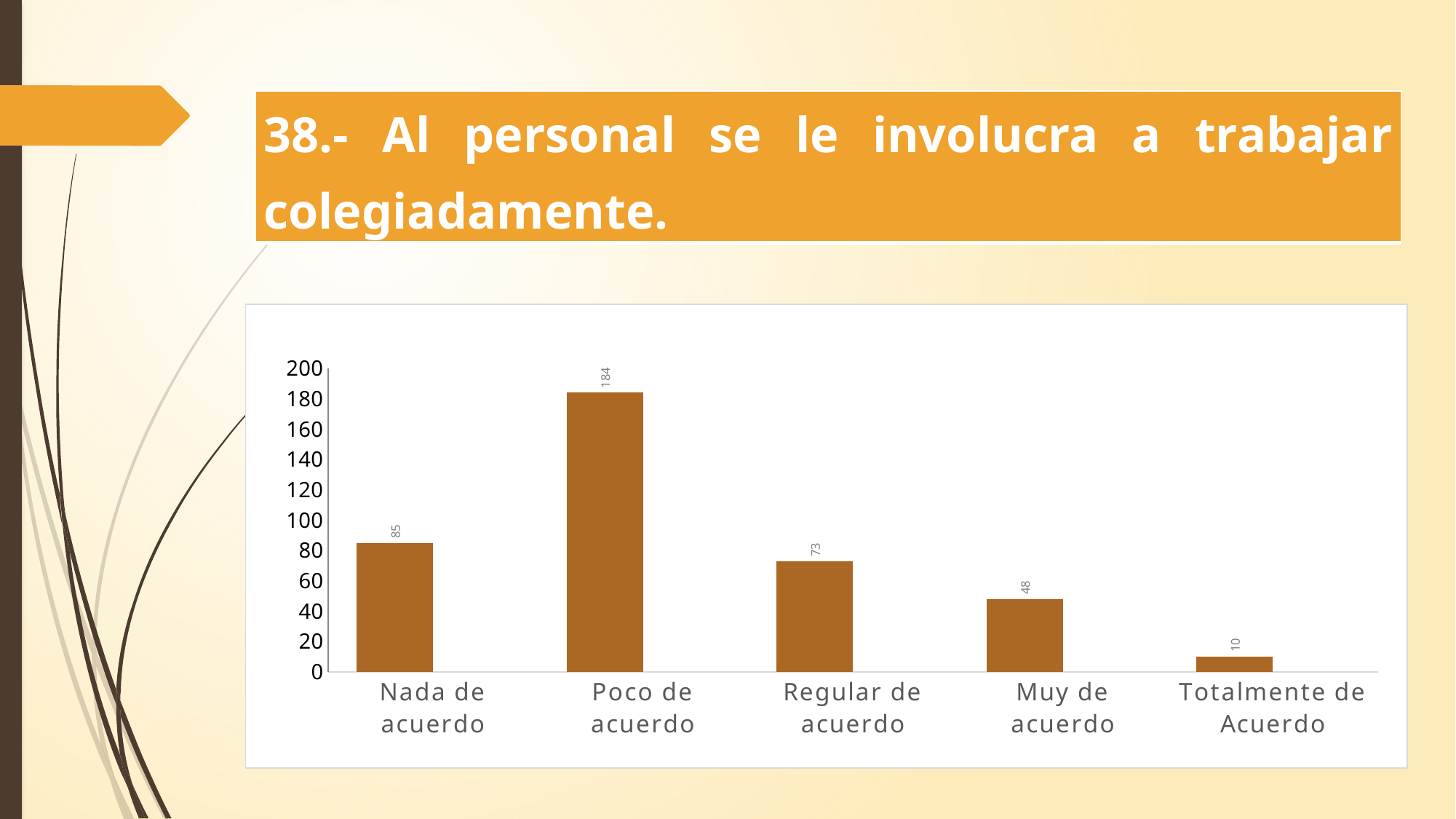
What is the difference between the values for Regular de acuerdo and Muy de acuerdo? 25 Which is larger, the value for Nada de acuerdo or the value for Regular de acuerdo? Nada de acuerdo Is the value for Poco de acuerdo greater or less than 160? greater What is the value for Poco de acuerdo? 184 What is the value for Muy de acuerdo? 48 What is the value for Totalmente de Acuerdo? 10 What is the difference between the values for Poco de acuerdo and Nada de acuerdo? 99 What is the value for Nada de acuerdo? 85 What kind of chart is shown on the slide? bar chart How many categories are shown on the x axis? 5 Which category has the lowest value? Totalmente de Acuerdo Which category has the highest value? Poco de acuerdo